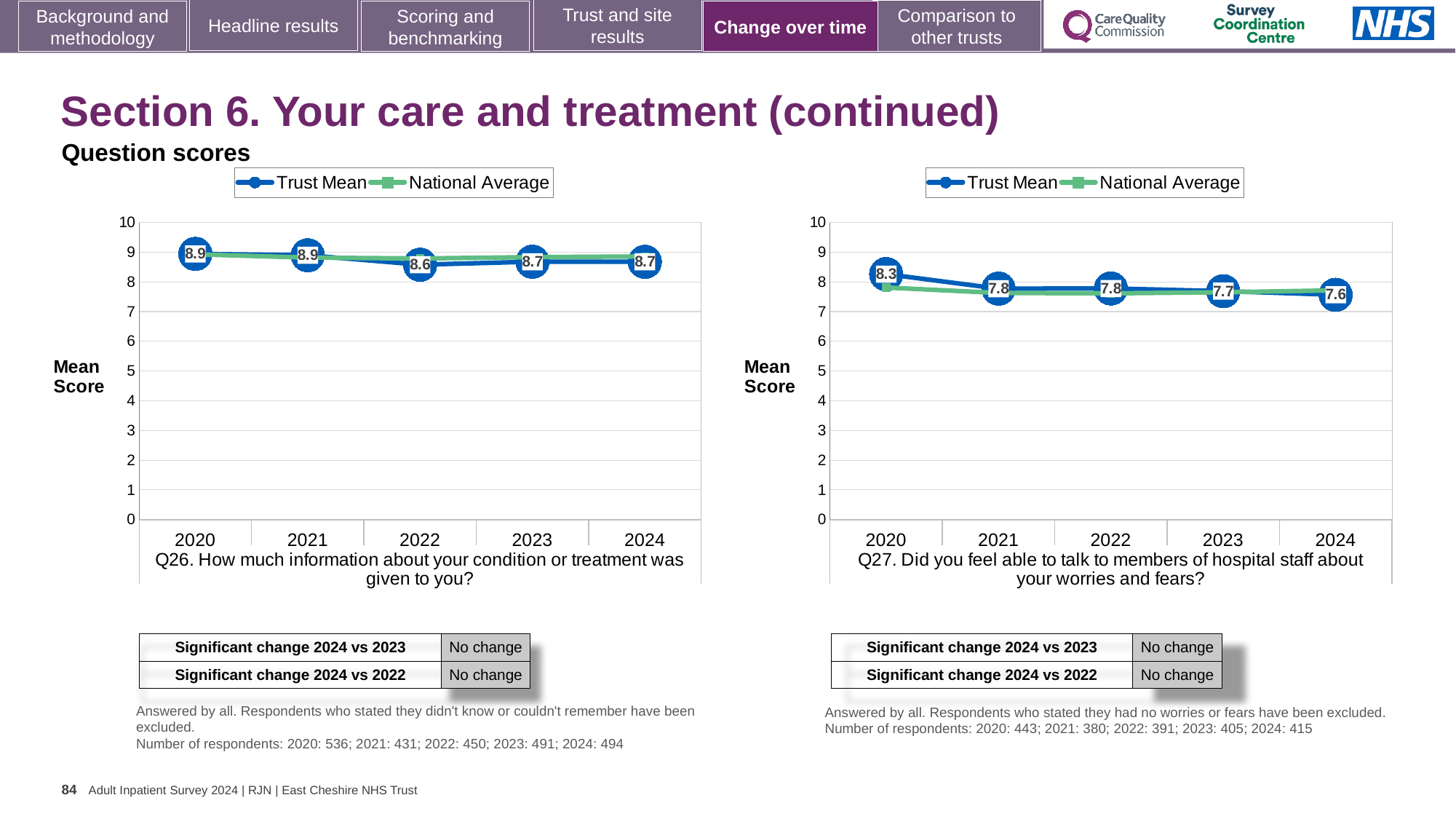
In the Q26 chart, which year has the lowest Trust Mean score? 2022 In the Q27 chart, which year has the highest Trust Mean score? 2020 In the Q27 chart, what is the Trust Mean score for 2020? 8.3 In the Q26 chart, what is the Trust Mean score for 2022? 8.6 In the Q26 chart, what is the Trust Mean score for 2020? 8.9 How many years are shown on the x axis of the Q26 chart? 5 What kind of chart is the Q26 chart? Line chart In the Q27 chart, is the National Average for 2020 greater or less than 9? less In the Q27 chart, what is the Trust Mean score for 2024? 7.6 In the Q27 chart, what is the difference between the Trust Mean score in 2020 and in 2024? 0.7 How many series does the legend of the Q27 chart list? 2 In the Q26 chart, is the Trust Mean score for 2020 or for 2022 larger? 2020